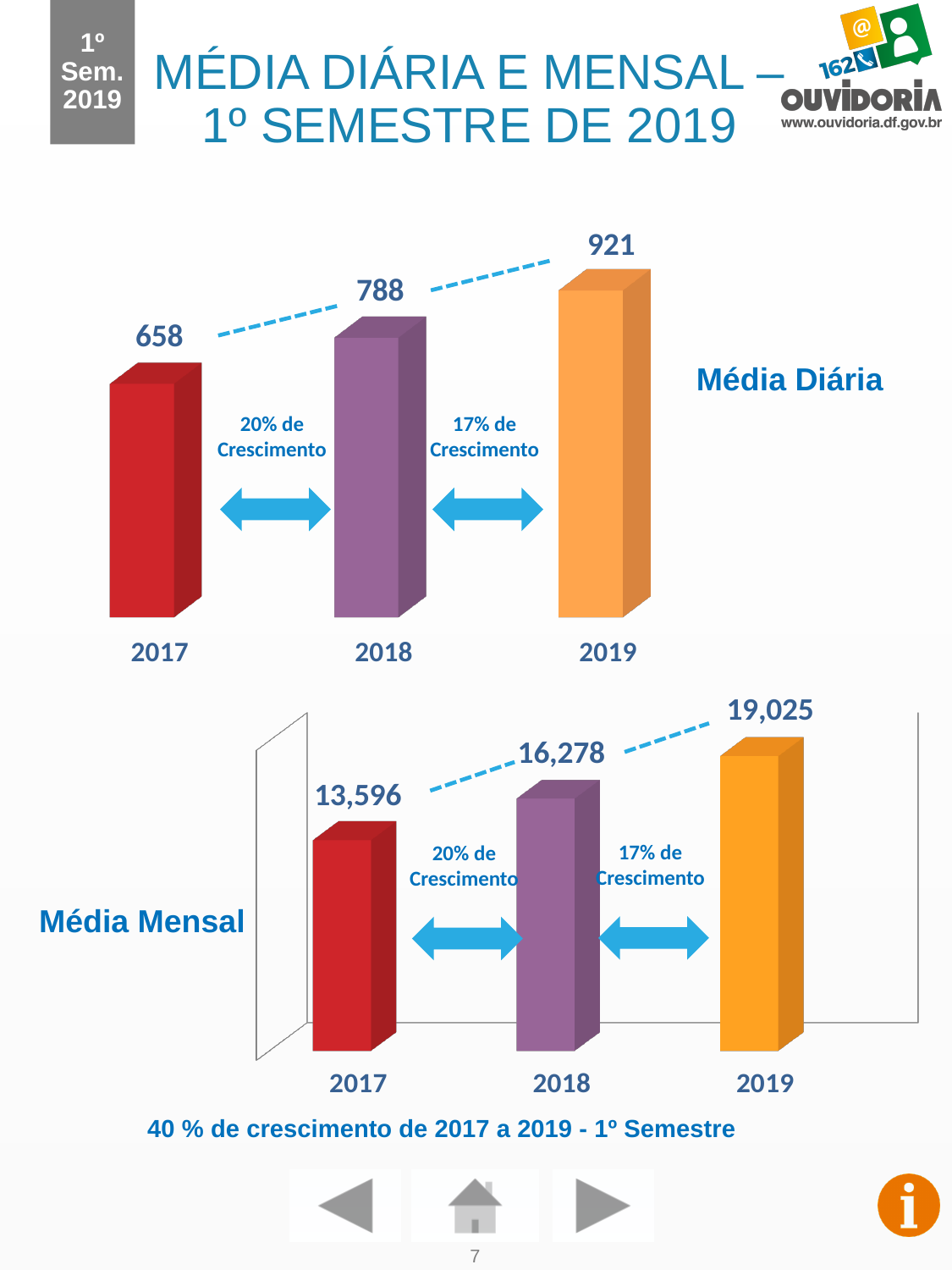
In the Média Diária chart, what is the value for 2019? 921 In the Média Mensal chart, which year has the lowest value? 2017 In the Média Mensal chart, what is the value for 2019? 19,025 In the Média Mensal chart, what is the value for 2018? 16,278 In the Média Mensal chart, what is the difference between the 2019 and 2018 values? 2,747 What kind of chart is the Média Mensal chart? bar chart In the Média Mensal chart, which is larger, the value for 2017 or the value for 2018? 2018 In the Média Diária chart, which year has the highest value? 2019 How many years are shown in the Média Diária chart? 3 In the Média Diária chart, what is the difference between the 2018 and 2017 values? 130 In the Média Diária chart, do the values rise or fall from 2017 to 2019? rise In the Média Diária chart, what is the value for 2017? 658